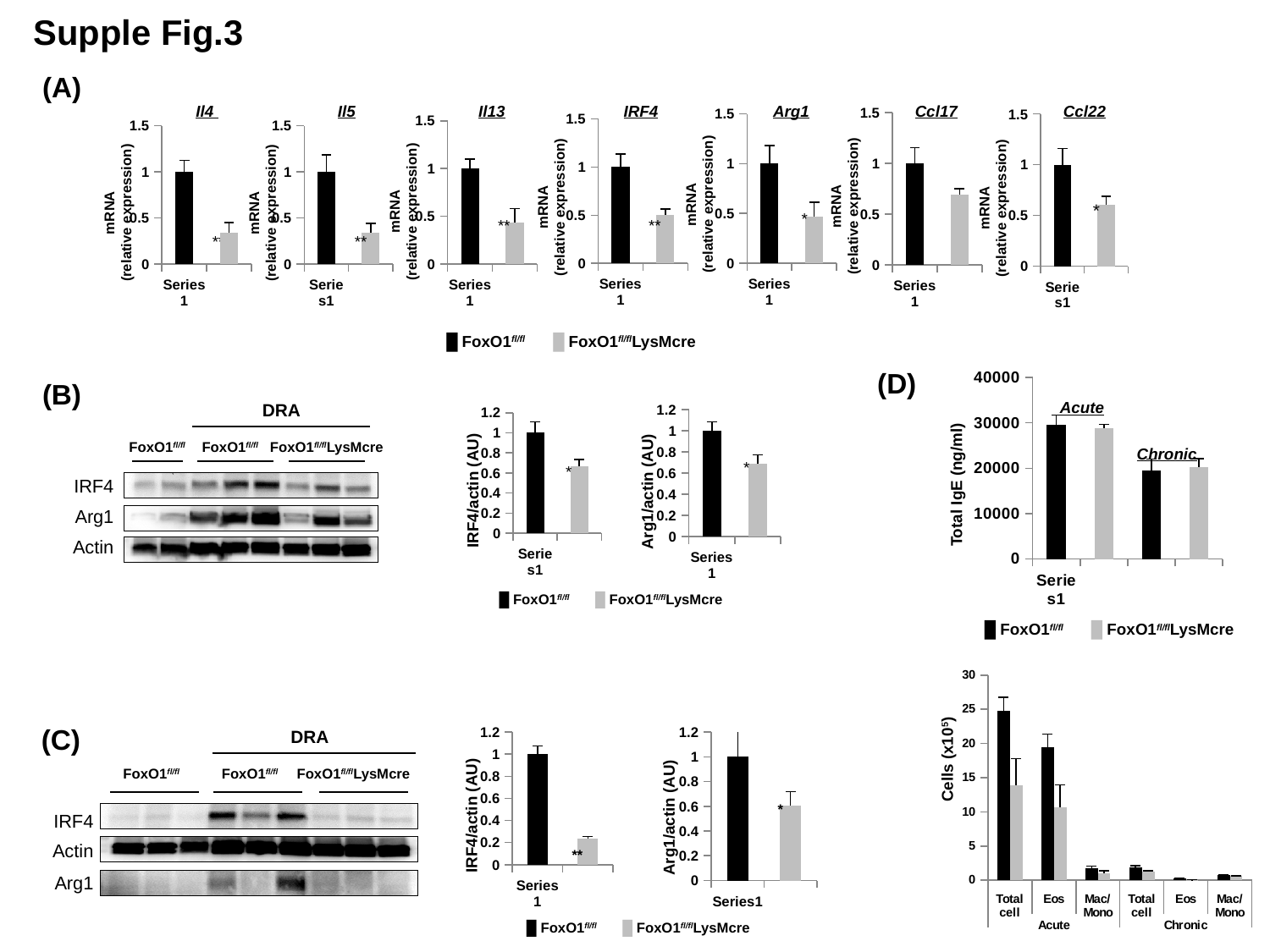
How many small bar charts are shown in panel (A)? 7 What kind of chart is the Il4 chart in panel (A)? bar chart In the IRF4/actin (AU) chart in panel (B), is the value for FoxO1fl/flLysMcre greater or less than 0.4? greater In the Cells (x10^5) chart in panel (D), how many categories are shown on the x axis? 6 In the Ccl17 chart in panel (A), is the value for FoxO1fl/flLysMcre greater or less than 0.5? greater In the IRF4/actin (AU) chart in panel (C), is the value for FoxO1fl/flLysMcre greater or less than 0.4? less How many series does the legend under panel (A) list? 2 In the Cells (x10^5) chart in panel (D), which category has the highest value? Total cell (Acute) In the Arg1 chart in panel (A), which series has the larger value, FoxO1fl/fl or FoxO1fl/flLysMcre? FoxO1fl/fl